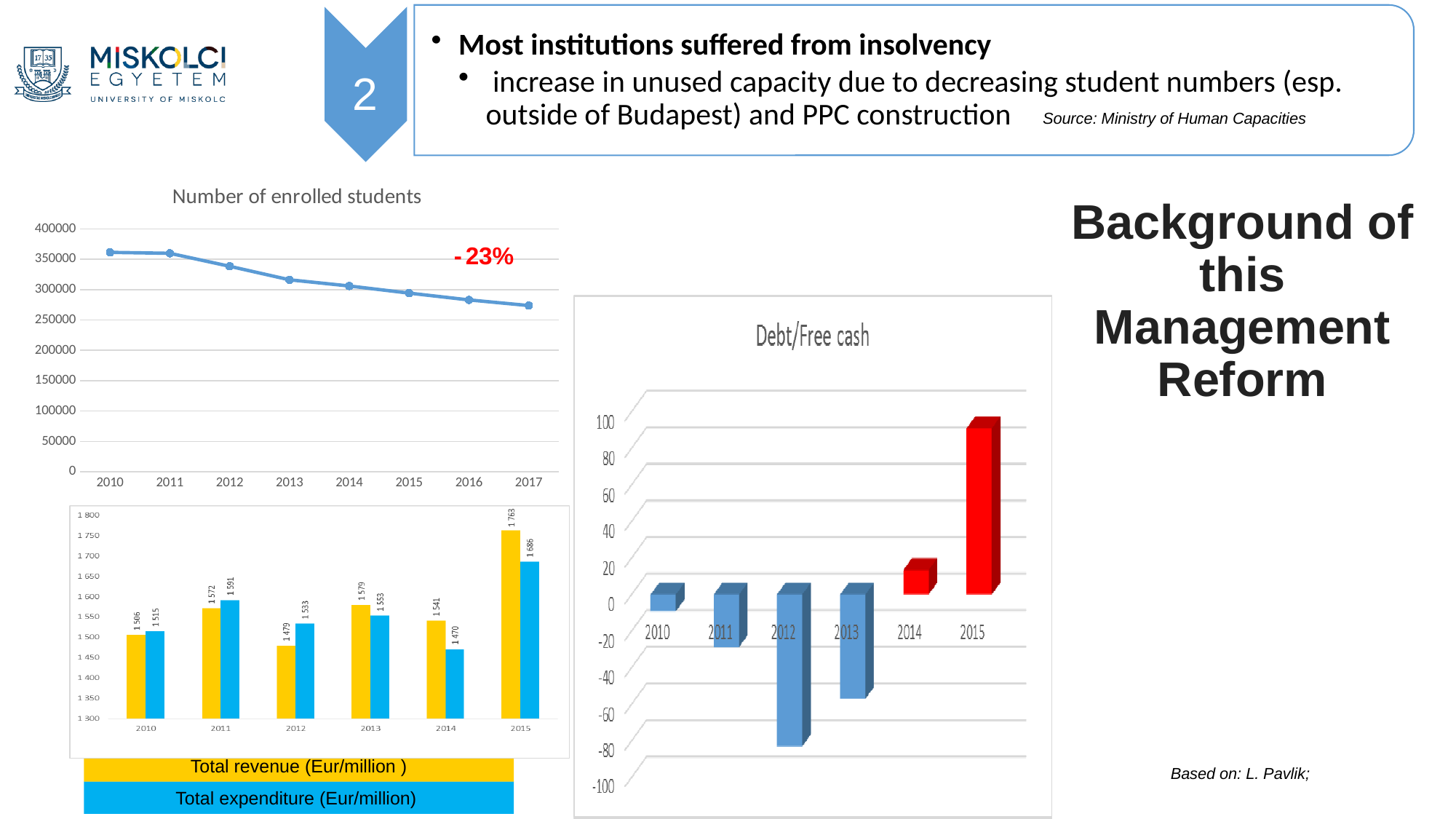
How many series does the legend of the revenue/expenditure bar chart list? 2 How many years are plotted in the "Number of enrolled students" chart? 8 In the revenue/expenditure bar chart at the bottom left, what is the Total revenue (Eur/million) for 2015? 1 763 In the "Number of enrolled students" chart, do the values rise or fall from 2010 to 2017? Fall In the revenue/expenditure bar chart at the bottom left, what is the Total expenditure (Eur/million) for 2014? 1 470 In the "Number of enrolled students" chart, is the value for 2017 greater or less than 300000? less In the revenue/expenditure bar chart at the bottom left, what is the difference between Total revenue and Total expenditure in 2015? 77 In the revenue/expenditure bar chart at the bottom left, which is larger in 2013: Total revenue or Total expenditure? Total revenue In the "Debt/Free cash" chart, which year has the lowest value? 2012 In the "Debt/Free cash" chart, is the value for 2015 greater or less than 80? greater In the revenue/expenditure bar chart at the bottom left, which year has the highest Total revenue? 2015 What kind of chart is the "Number of enrolled students" chart? Line chart